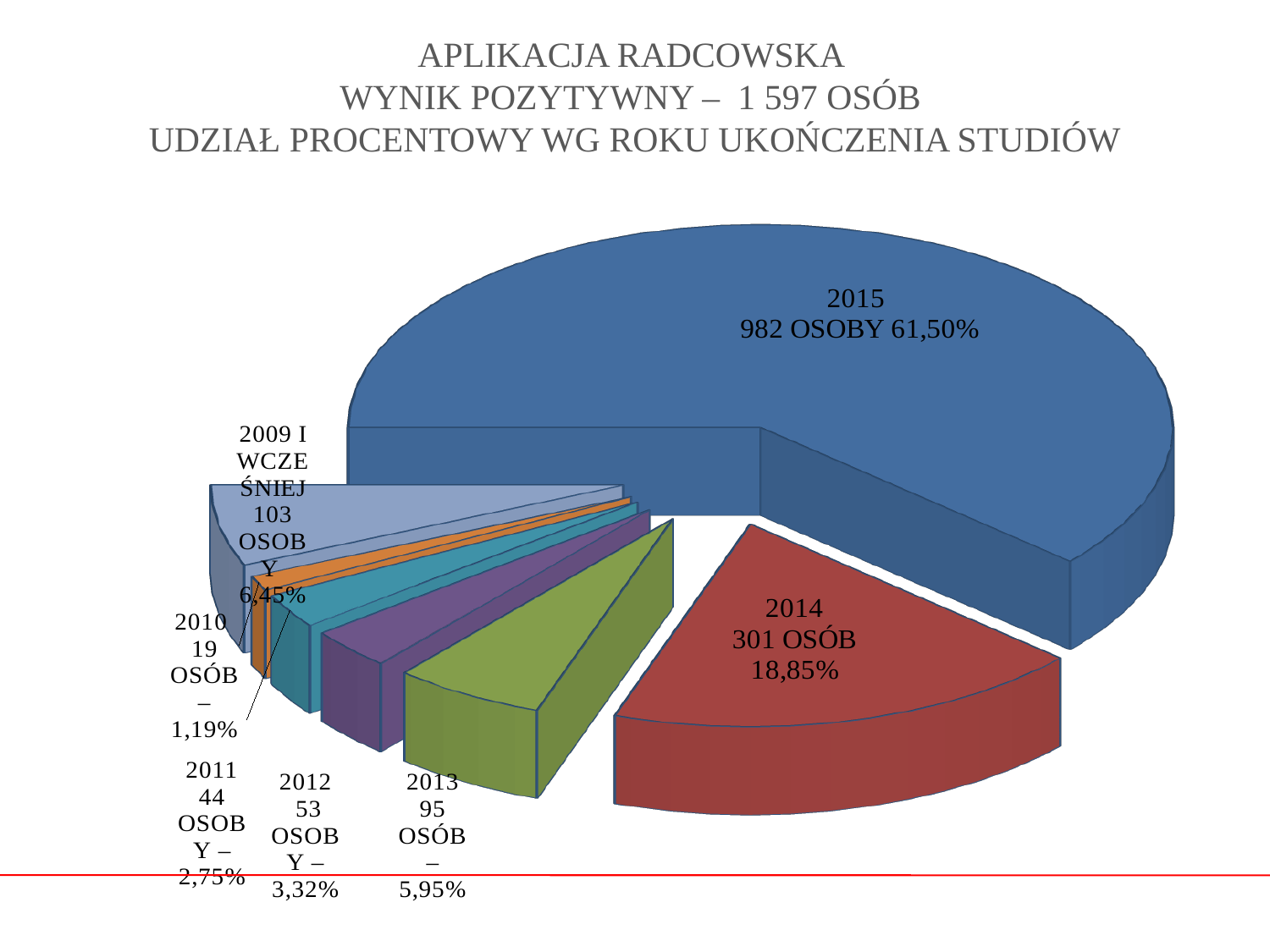
What kind of chart is shown on the slide? pie chart What is the difference in number of people between the 2015 and 2014 slices? 681 How many people are in the 2014 slice? 301 How many people are in the 2010 slice? 19 How many slices does the pie chart have? 7 What percentage share does the 2013 slice have? 5,95% What percentage share does the '2009 I WCZEŚNIEJ' slice have? 6,45% What total number of people is stated in the chart title? 1 597 What percentage share does the 2015 slice have? 61,50% Which slice is larger, 2012 or 2011? 2012 Which year has the largest slice of the pie? 2015 Which year has the smallest slice of the pie? 2010